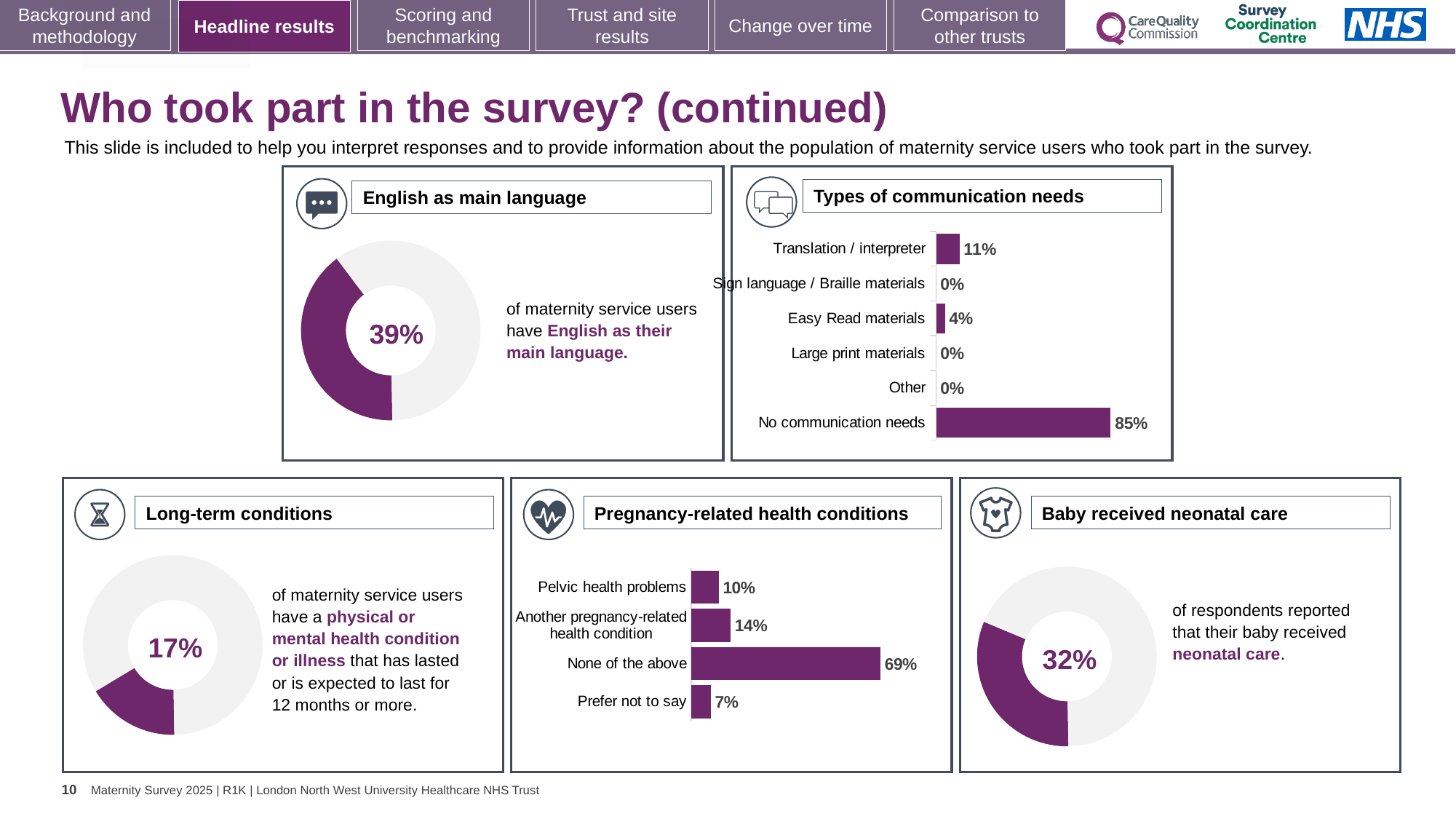
In the 'Pregnancy-related health conditions' chart, what is the difference between None of the above and Pelvic health problems? 59% In the 'Pregnancy-related health conditions' chart, which is larger: Pelvic health problems or Another pregnancy-related health condition? Another pregnancy-related health condition In the 'Pregnancy-related health conditions' chart, what is the value for Another pregnancy-related health condition? 14% In the 'Pregnancy-related health conditions' chart, which category has the lowest value? Prefer not to say In the 'English as main language' chart, what percentage of maternity service users have English as their main language? 39% In the 'Long-term conditions' chart, what percentage of maternity service users have a physical or mental health condition or illness? 17% In the 'Types of communication needs' chart, how many categories are shown? 6 In the 'Types of communication needs' chart, what is the value for Translation / interpreter? 11% In the 'Types of communication needs' chart, what is the difference between No communication needs and Translation / interpreter? 74% In the 'Baby received neonatal care' chart, what percentage of respondents reported that their baby received neonatal care? 32% In the 'Types of communication needs' chart, which category has the highest value? No communication needs What kind of chart is the 'Types of communication needs' chart? Bar chart